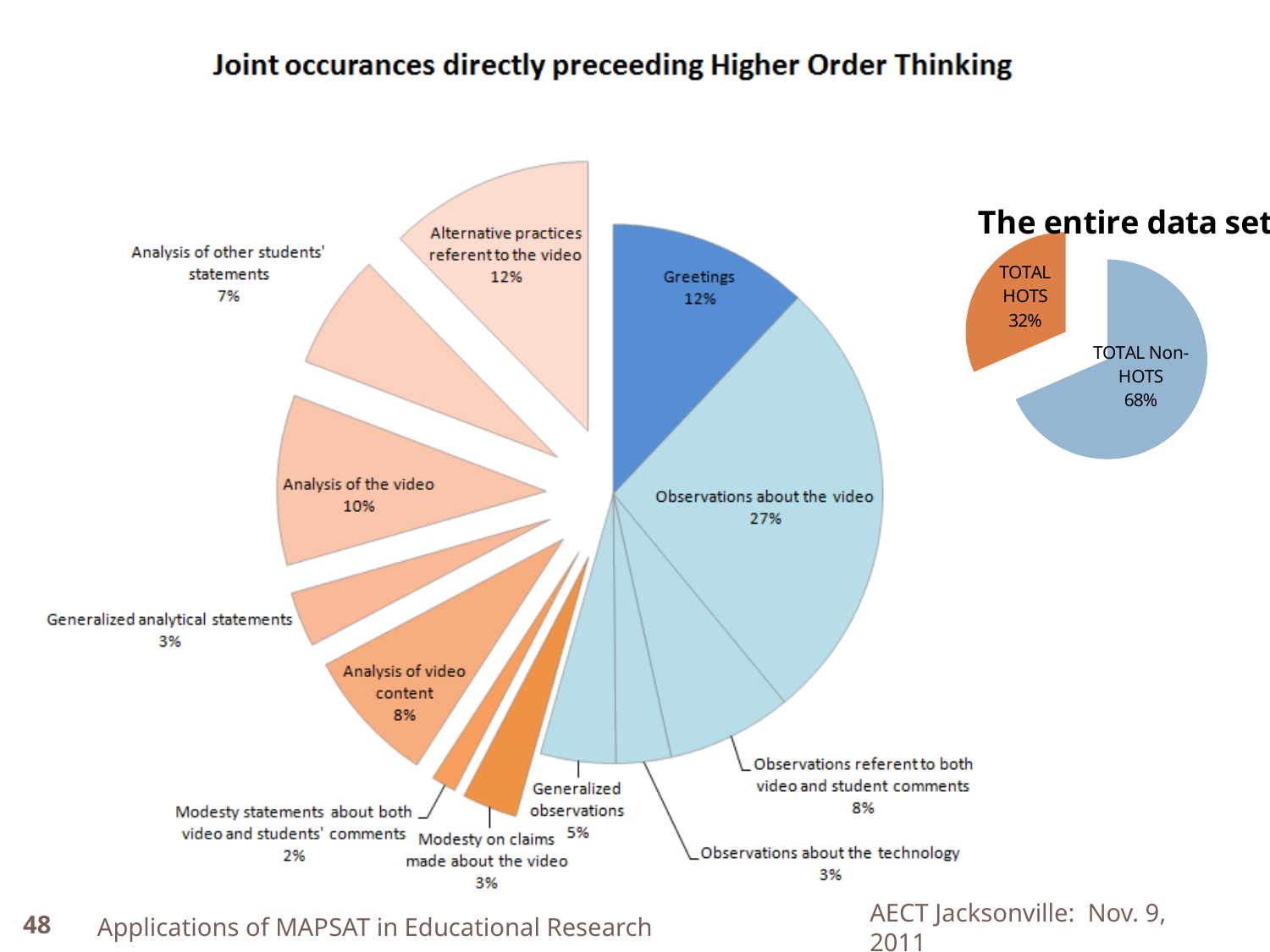
In 'The entire data set' chart, what is the difference between the TOTAL Non-HOTS and TOTAL HOTS shares? 36% In 'The entire data set' chart, what share is labelled for TOTAL HOTS? 32% In the 'Joint occurances directly preceeding Higher Order Thinking' chart, what is the difference between the shares for Observations about the video and Greetings? 15% What kind of chart is the 'Joint occurances directly preceeding Higher Order Thinking' chart? Pie chart In the 'Joint occurances directly preceeding Higher Order Thinking' chart, which is larger: Analysis of video content or Generalized observations? Analysis of video content How many slices does the 'Joint occurances directly preceeding Higher Order Thinking' pie chart have? 12 In the 'Joint occurances directly preceeding Higher Order Thinking' chart, which category has the largest slice? Observations about the video In the 'Joint occurances directly preceeding Higher Order Thinking' chart, what share is labelled for Analysis of the video? 10% In the 'Joint occurances directly preceeding Higher Order Thinking' chart, which category has the smallest slice? Modesty statements about both video and students' comments In 'The entire data set' chart, what share is labelled for TOTAL Non-HOTS? 68% In the 'Joint occurances directly preceeding Higher Order Thinking' chart, what share is labelled for Modesty statements about both video and students' comments? 2% In the 'Joint occurances directly preceeding Higher Order Thinking' chart, what share is labelled for Observations about the video? 27%